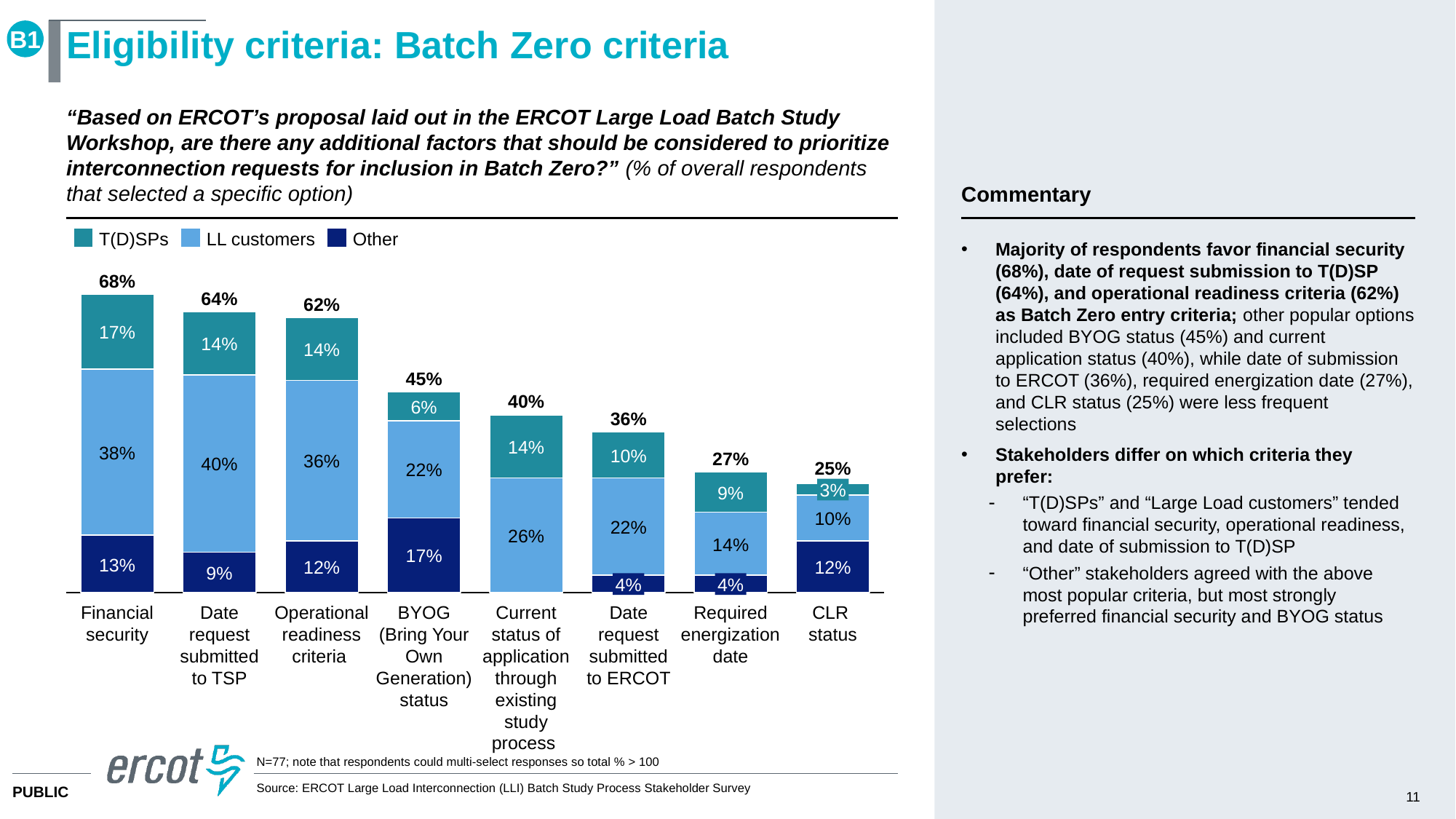
Which category has the highest total percentage? Financial security What type of chart is shown on the slide? Stacked bar chart What is the difference between the total for Financial security and the total for Required energization date? 41% What is the total percentage for Financial security? 68% Which category has the lowest total percentage? CLR status Which series is shown in the darkest blue colour in the legend? Other What is the Other value for CLR status? 12% What is the LL customers value for Date request submitted to TSP? 40% What is the T(D)SPs value for BYOG (Bring Your Own Generation) status? 6% How many series does the legend list? 3 How many categories are shown on the x axis? 8 Which is larger, the LL customers value for Operational readiness criteria or the LL customers value for Current status of application through existing study process? Operational readiness criteria